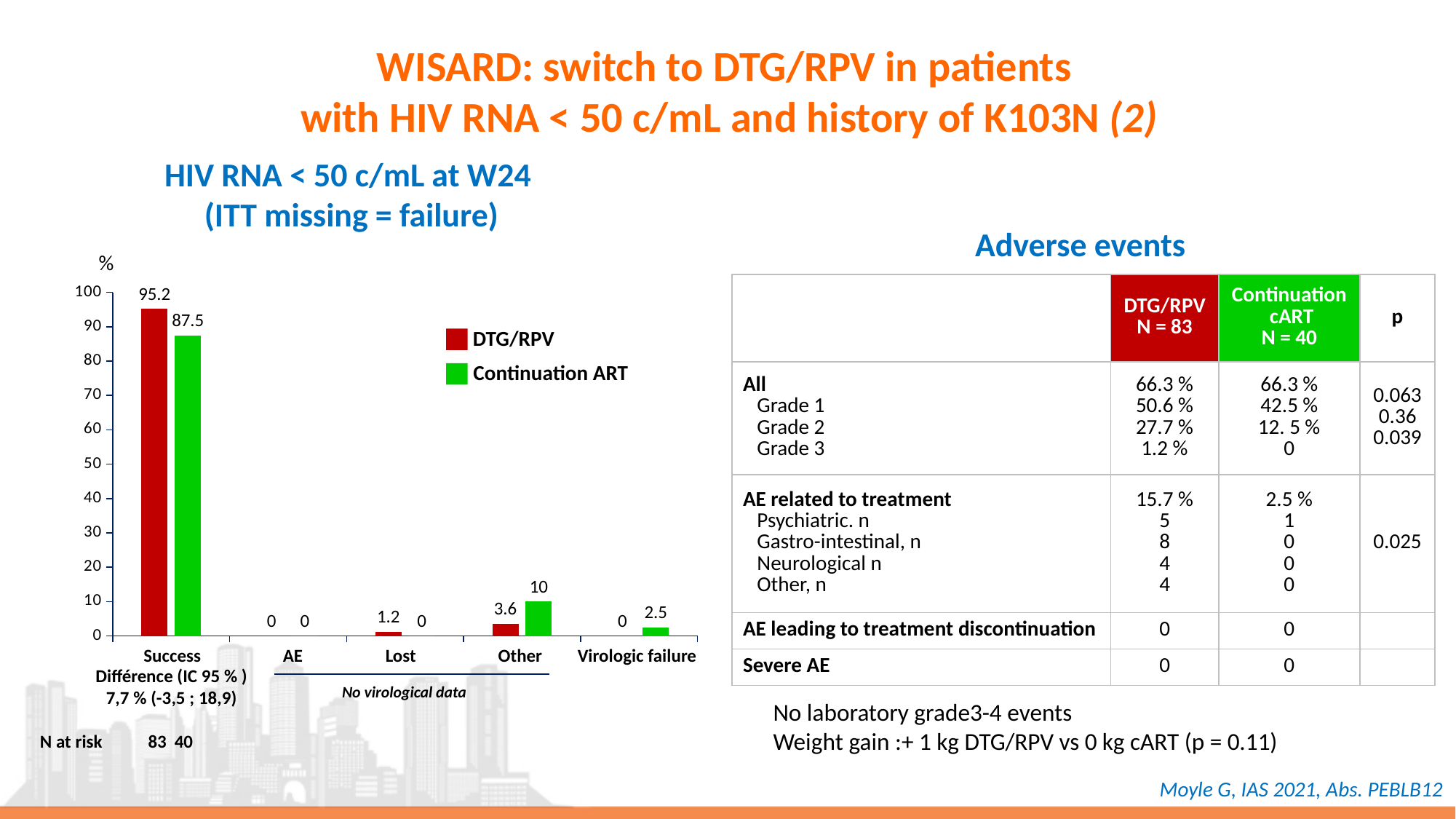
What is the Success value for DTG/RPV in the bar chart? 95.2 What is the Success value for Continuation ART in the bar chart? 87.5 What is the difference between the DTG/RPV and Continuation ART Success values? 7.7 Which colour represents DTG/RPV in the bar chart? Red Which category has the highest value for DTG/RPV? Success What is the value for Continuation ART in the Other category? 10 What is the value for DTG/RPV in the Lost category? 1.2 What is the Virologic failure value for Continuation ART? 2.5 How many series does the chart legend list? 2 How many categories are shown on the x axis of the bar chart? 5 What kind of chart is shown on the slide? Bar chart In the Other category, which series has the larger value, DTG/RPV or Continuation ART? Continuation ART